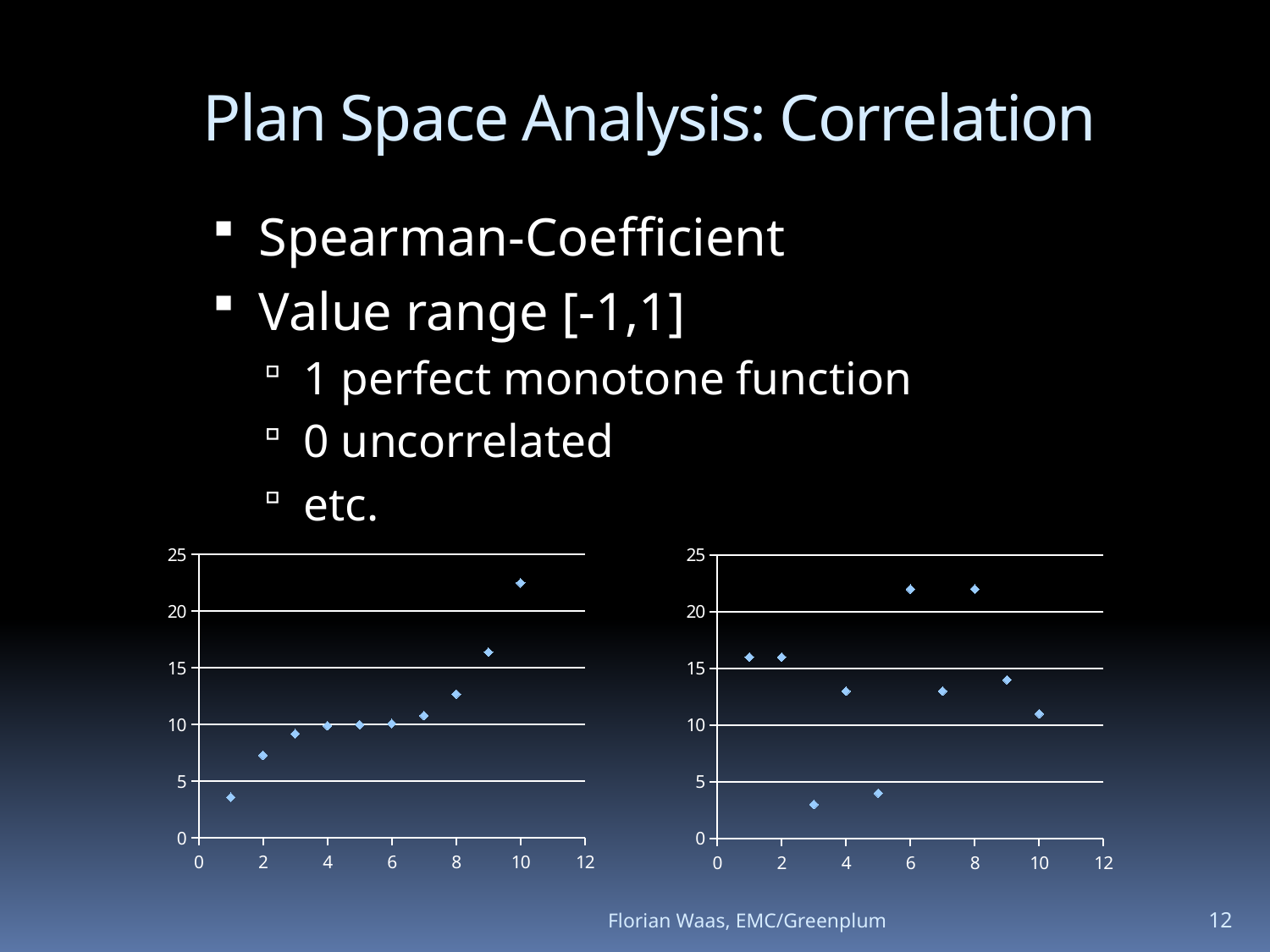
In the left chart, is the value at x = 10 greater or less than 20? greater In the left chart, how many data points are plotted? 10 In the left chart, do the values generally rise or fall as x increases? rise What kind of chart is the chart on the right of the slide? scatter chart In the right chart, is the value at x = 3 greater or less than 5? less What kind of chart is the chart on the left of the slide? scatter chart In the left chart, is the value at x = 1 greater or less than 5? less In the left chart, at which x value is the highest point plotted? 10 In the right chart, how many data points are plotted? 10 In the right chart, which has the larger value: the point at x = 6 or the point at x = 3? x = 6